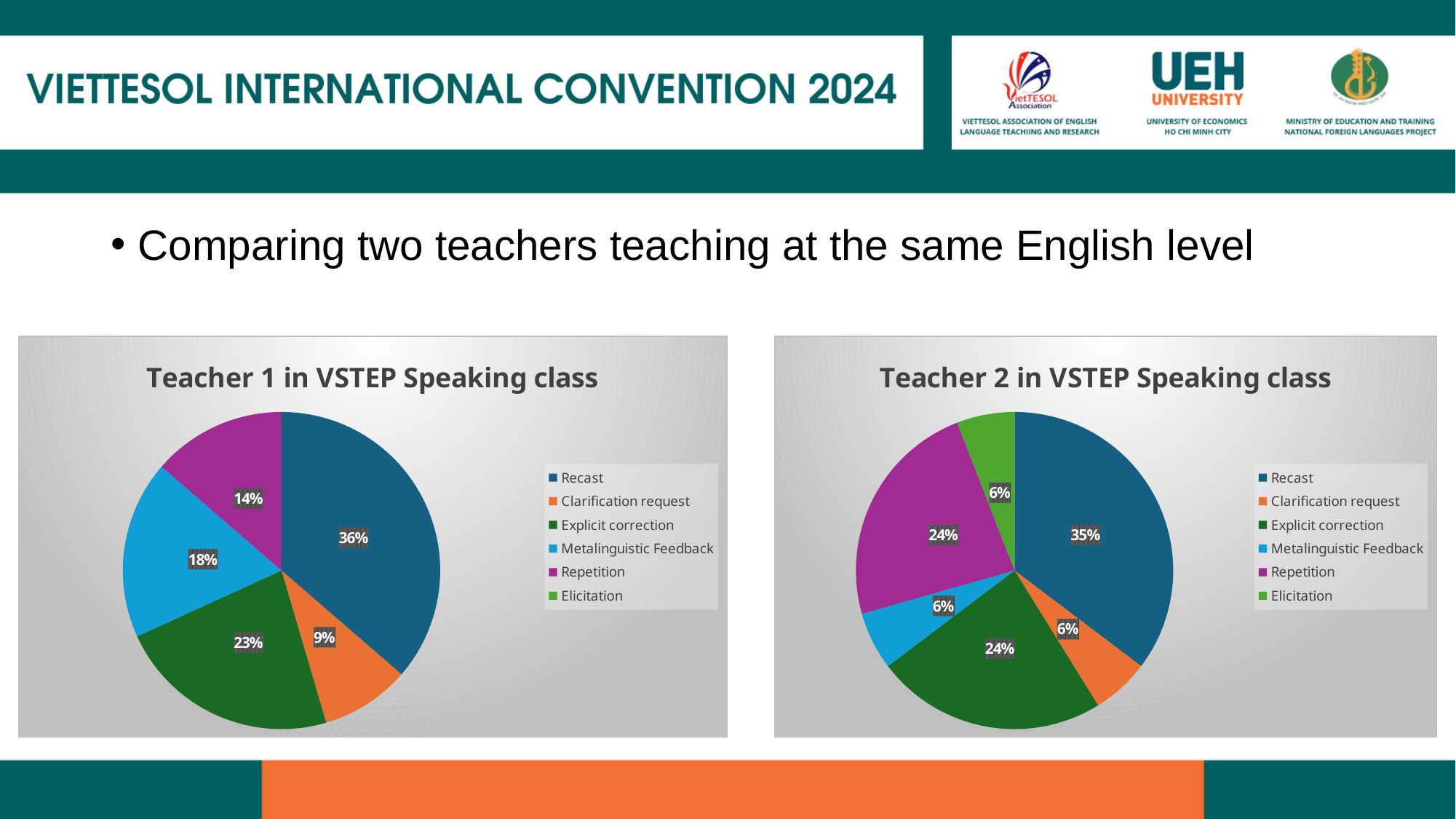
In the 'Teacher 1 in VSTEP Speaking class' chart, what is the difference between Explicit correction and Repetition? 9% What type of chart is used for 'Teacher 1 in VSTEP Speaking class'? Pie chart In the 'Teacher 1 in VSTEP Speaking class' chart, which labelled category has the smallest share? Clarification request In the 'Teacher 2 in VSTEP Speaking class' chart, what percentage is Repetition? 24% In the 'Teacher 1 in VSTEP Speaking class' chart, which category has the largest share? Recast In the 'Teacher 1 in VSTEP Speaking class' chart, what percentage is Recast? 36% In the 'Teacher 2 in VSTEP Speaking class' chart, what percentage is Elicitation? 6% How many slices does the 'Teacher 2 in VSTEP Speaking class' pie chart have? 6 In the 'Teacher 2 in VSTEP Speaking class' chart, which category has the largest share? Recast In the 'Teacher 1 in VSTEP Speaking class' chart, what percentage is Metalinguistic Feedback? 18% Which is larger: Metalinguistic Feedback for Teacher 1 or Metalinguistic Feedback for Teacher 2? Teacher 1 In the 'Teacher 2 in VSTEP Speaking class' chart, what is the difference between Recast and Explicit correction? 11%